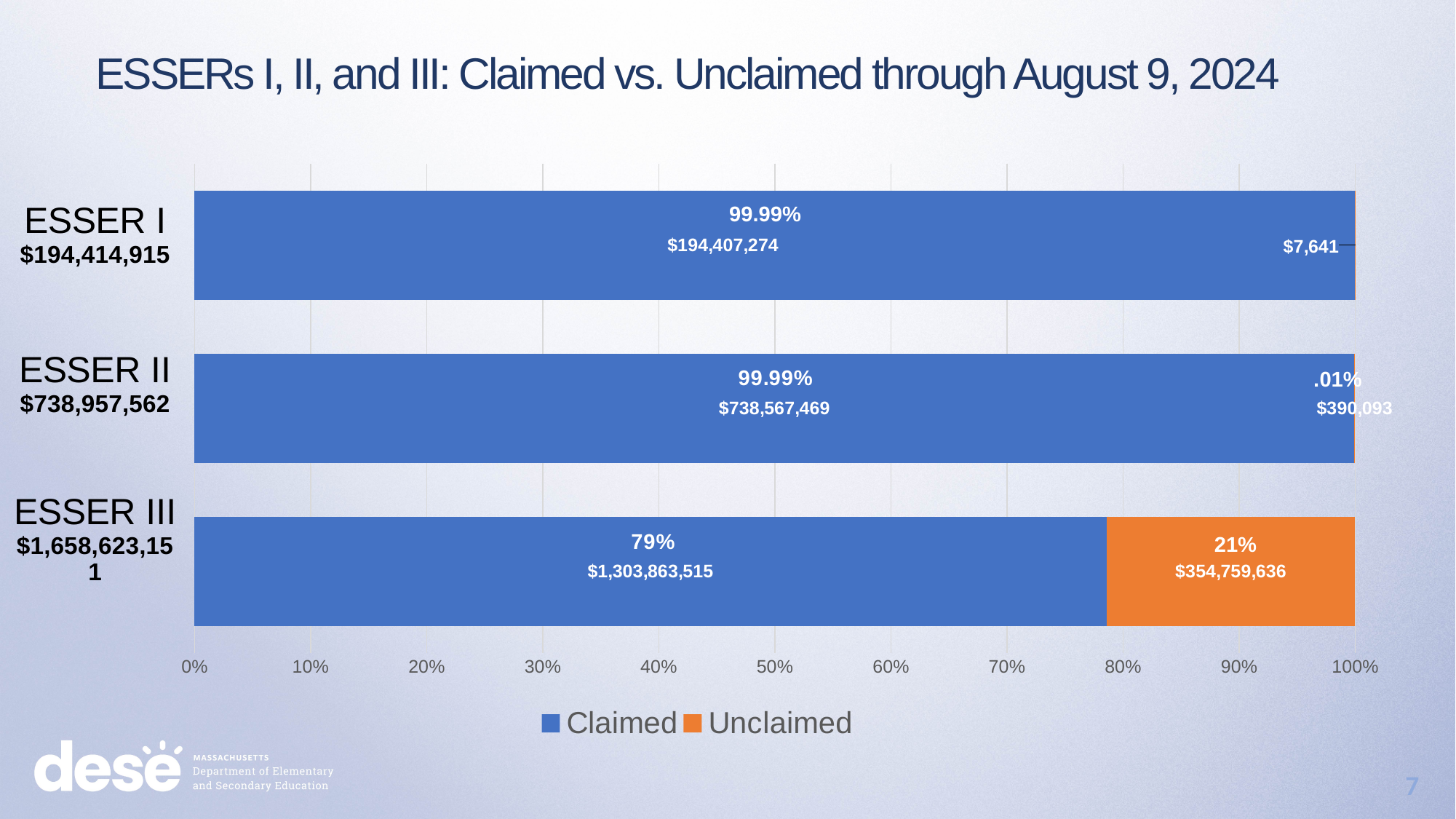
What is the Unclaimed dollar amount for ESSER I? $7,641 What is the Unclaimed dollar amount for ESSER III? $354,759,636 What percentage of ESSER III is shown as Claimed? 79% Which ESSER category has the largest Unclaimed share? ESSER III What percentage of ESSER II is shown as Unclaimed? .01% Is the Claimed share for ESSER III greater or less than 80%? less What is the difference between the Claimed and Unclaimed dollar amounts for ESSER III? $949,103,879 How many series does the legend list? 2 How many ESSER categories are plotted in the chart? 3 What kind of chart is shown on the slide? bar chart What is the Claimed dollar amount for ESSER II? $738,567,469 Which has the larger Claimed dollar amount, ESSER I or ESSER II? ESSER II